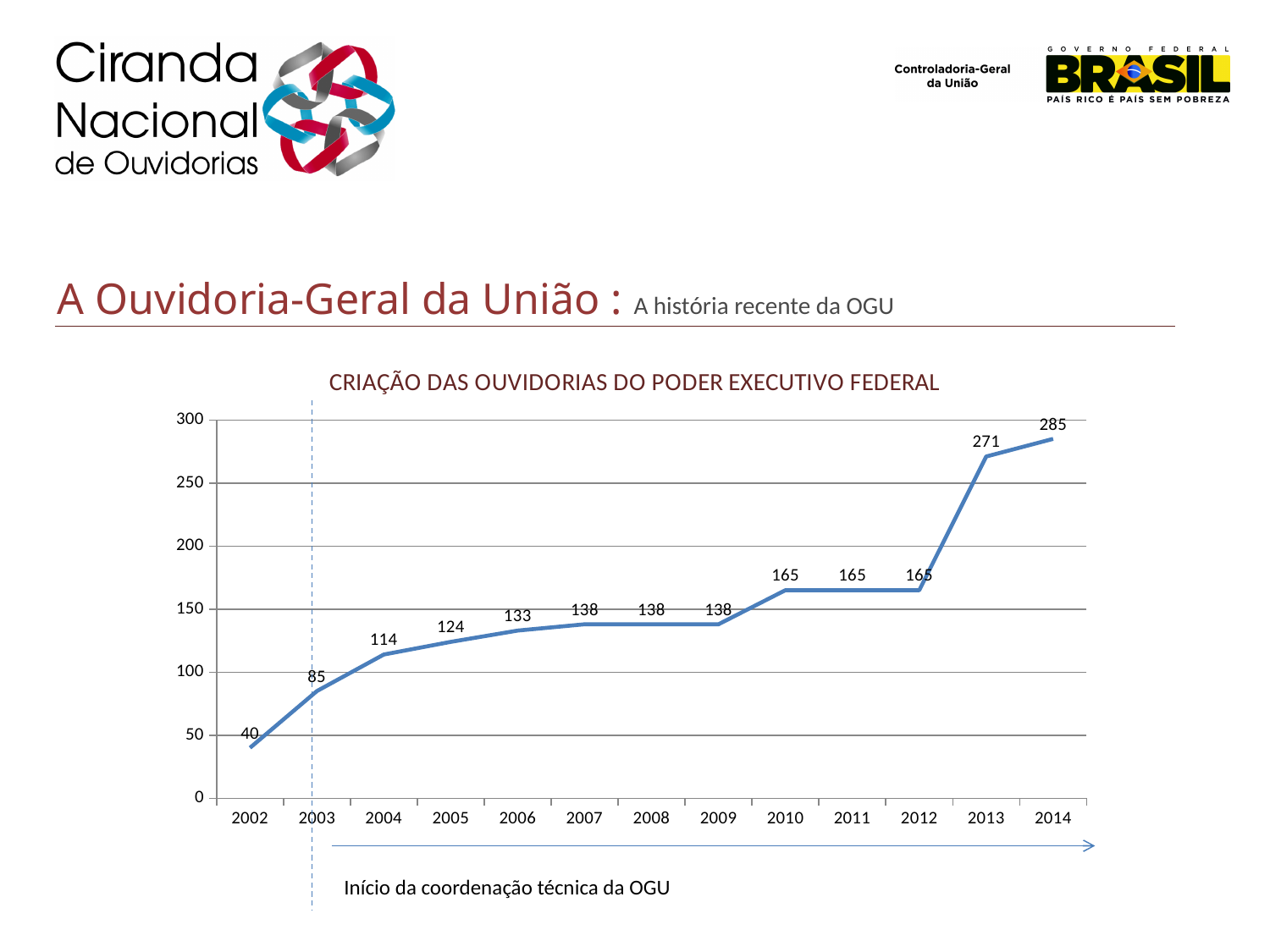
What is the value for 2007? 138 What is the value for 2002? 40 What is the value for 2013? 271 What is the difference between the values for 2014 and 2013? 14 What kind of chart is shown? line chart What is the title of the chart? CRIAÇÃO DAS OUVIDORIAS DO PODER EXECUTIVO FEDERAL Which year has the lowest value? 2002 Which year has the highest value? 2014 What is the difference between the values for 2003 and 2002? 45 How many years are plotted on the x axis? 13 Is the value for 2004 greater or less than 100? greater Which is larger, the value for 2006 or the value for 2010? 2010